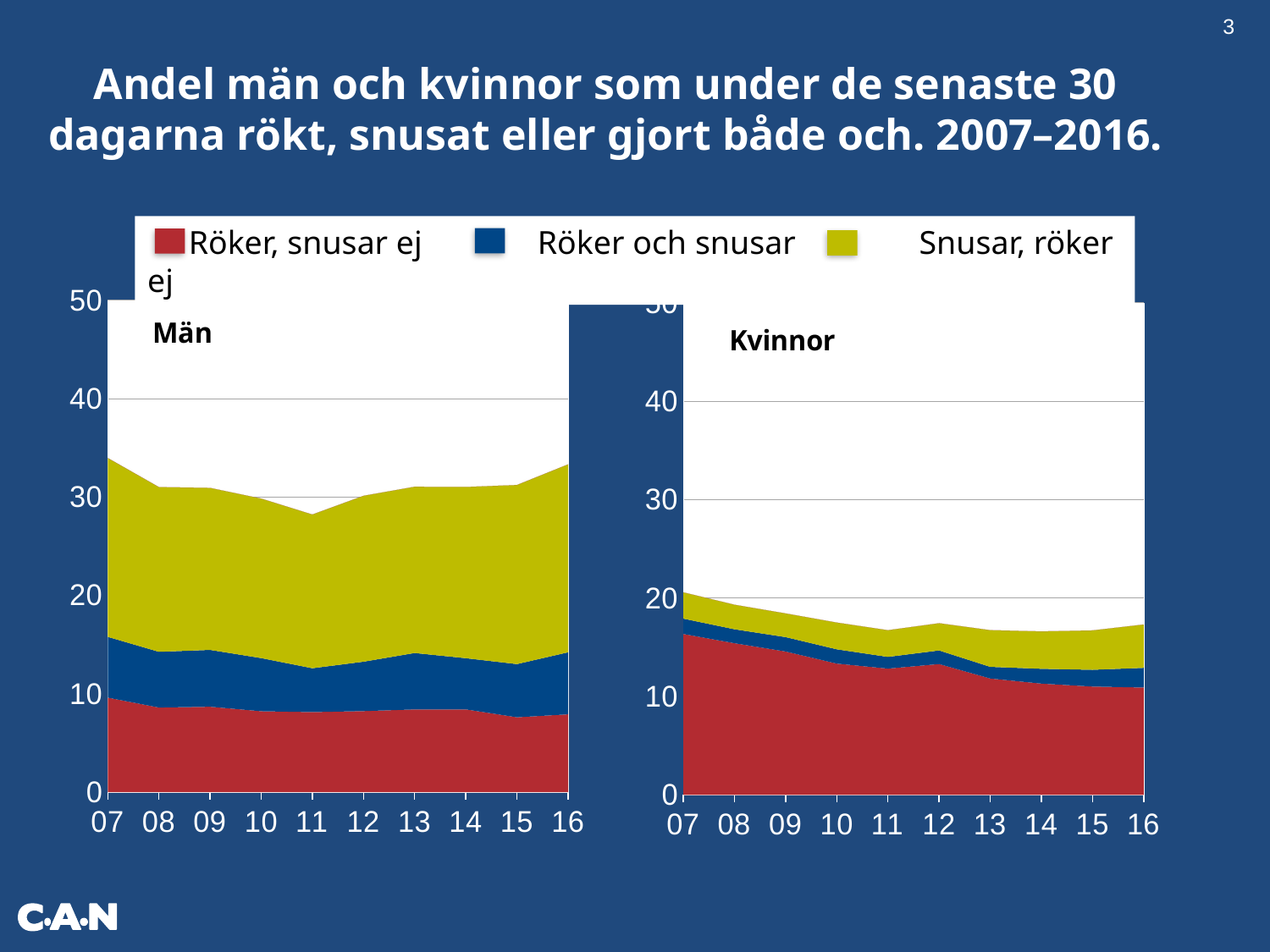
Which chart has the larger total stacked value in 07, "Män" or "Kvinnor"? Män What is the label of the left chart? Män Which colour represents "Röker och snusar" in the legend? blue What kind of chart is the "Män" chart? stacked area chart In the "Kvinnor" chart, is the total stacked value for 16 greater or less than 20? less How many series does the legend list? 3 In the "Kvinnor" chart, does the "Röker, snusar ej" series rise or fall from 07 to 16? fall How many years are shown on the x axis of the "Kvinnor" chart? 10 In the "Män" chart, is the total stacked value for 07 greater or less than 30? greater In the "Män" chart, is the value for "Röker, snusar ej" in 16 greater or less than 10? less